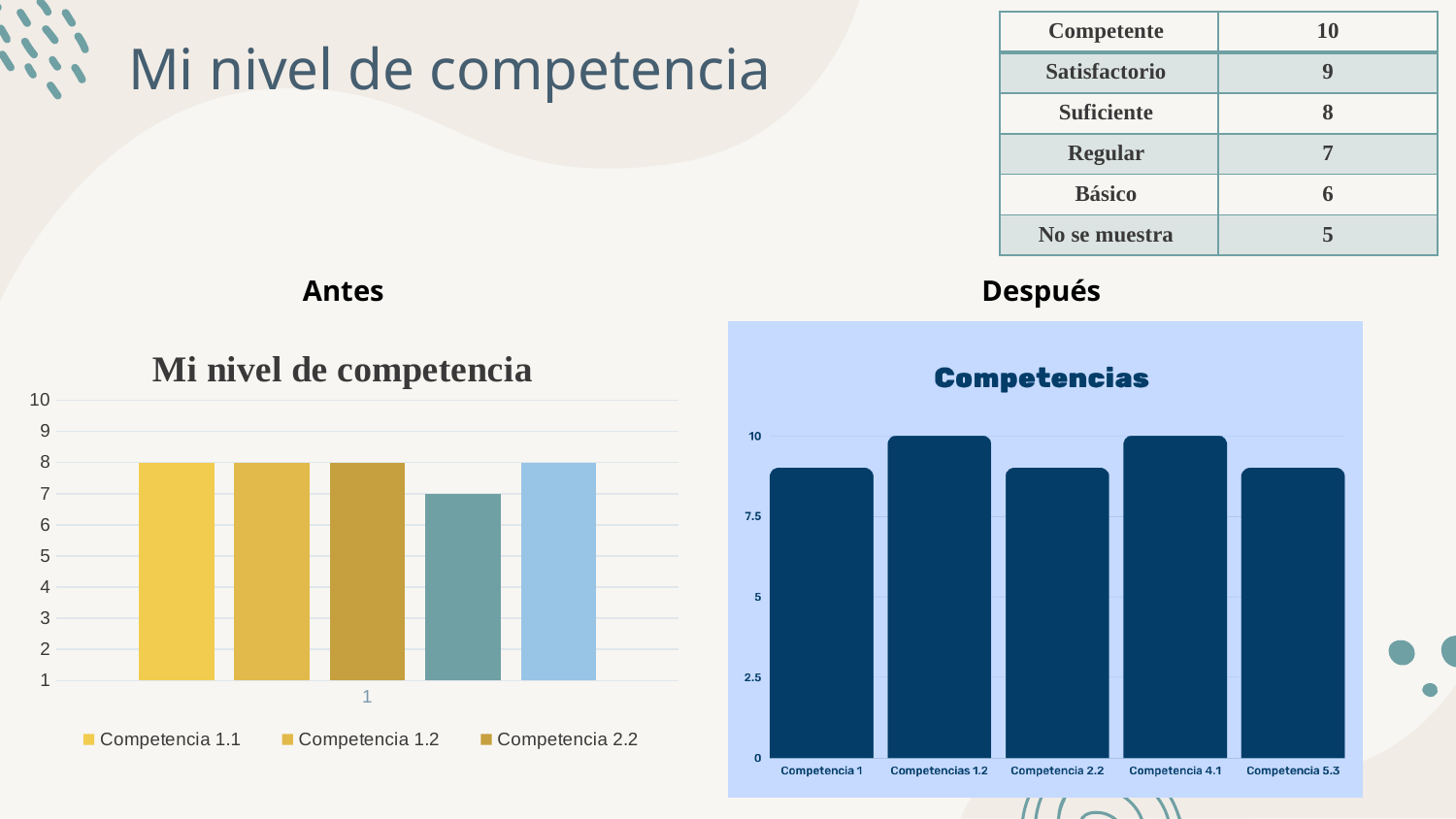
In the 'Competencias' chart on the right, what is the value for Competencias 1.2? 10 In the 'Competencias' chart on the right, what is the value for Competencia 4.1? 10 In the 'Competencias' chart on the right, is the value for Competencia 1 greater or less than 7.5? greater In the 'Competencias' chart on the right, how many categories are shown on the x axis? 5 In the 'Mi nivel de competencia' chart on the left, how many bars are plotted? 5 In the 'Mi nivel de competencia' chart on the left, what is the value for Competencia 1.1? 8 What is the title of the chart on the right side of the slide? Competencias In the 'Mi nivel de competencia' chart on the left, how many series does the legend list? 3 In the 'Mi nivel de competencia' chart on the left, what is the value for Competencia 2.2? 8 In the 'Mi nivel de competencia' chart on the left, is the value for Competencia 1.2 greater or less than 5? greater In the 'Competencias' chart on the right, which is larger, Competencias 1.2 or Competencia 2.2? Competencias 1.2 In the 'Mi nivel de competencia' chart on the left, what kind of chart is shown? bar chart